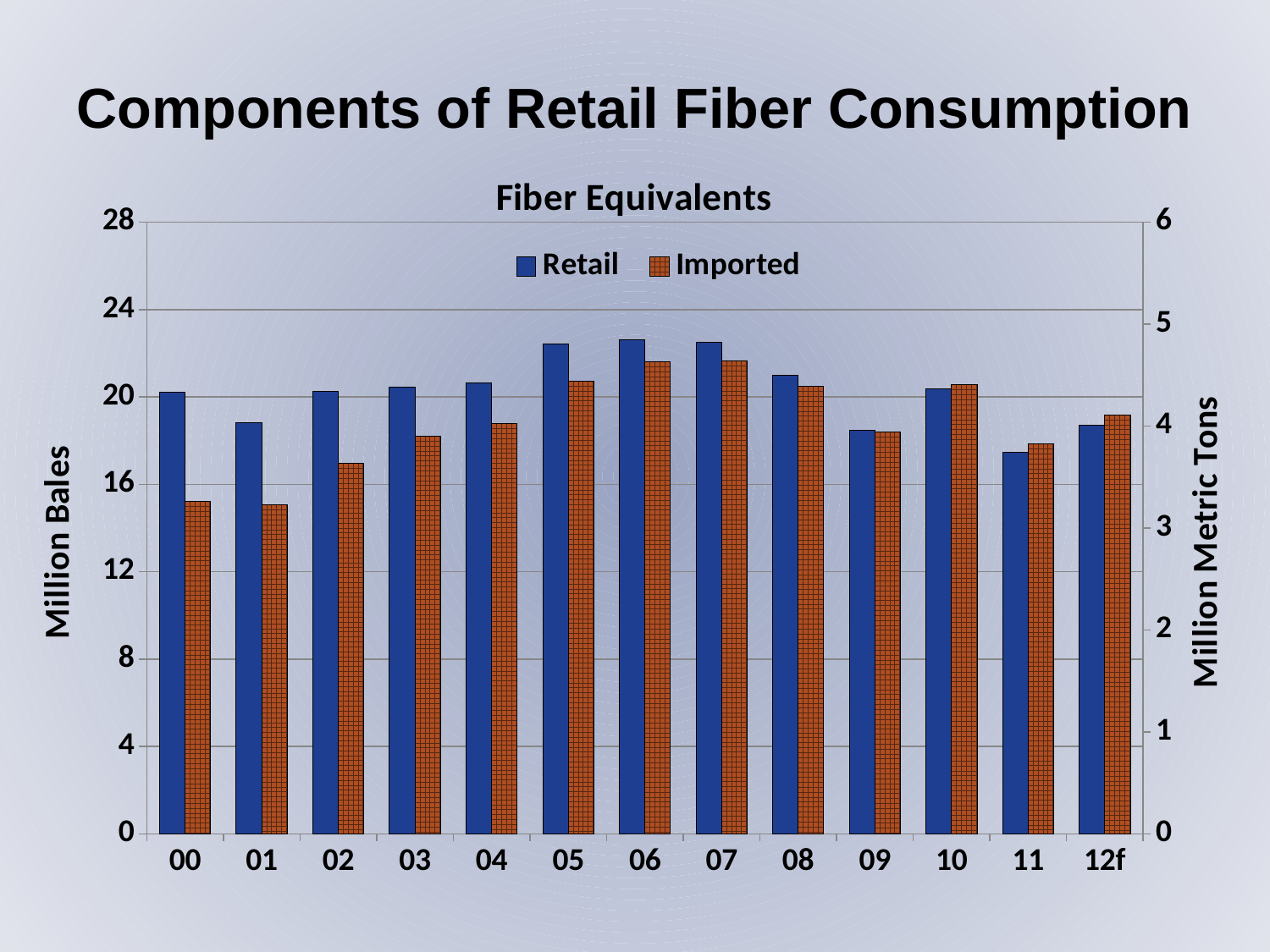
In 00, which is larger, Retail or Imported? Retail How many year categories are shown on the x axis? 13 Is the Retail value for 05 greater or less than 20 million bales? greater Which year has the lowest Retail value? 11 Do the Imported values rise or fall from 00 to 06? rise What is the label of the left vertical axis? Million Bales What kind of chart is shown on the slide? bar chart What is the label of the right vertical axis? Million Metric Tons Is the Imported value for 00 greater or less than 16 million bales? less How many series does the legend list? 2 Is the Retail value for 11 greater or less than 20 million bales? less